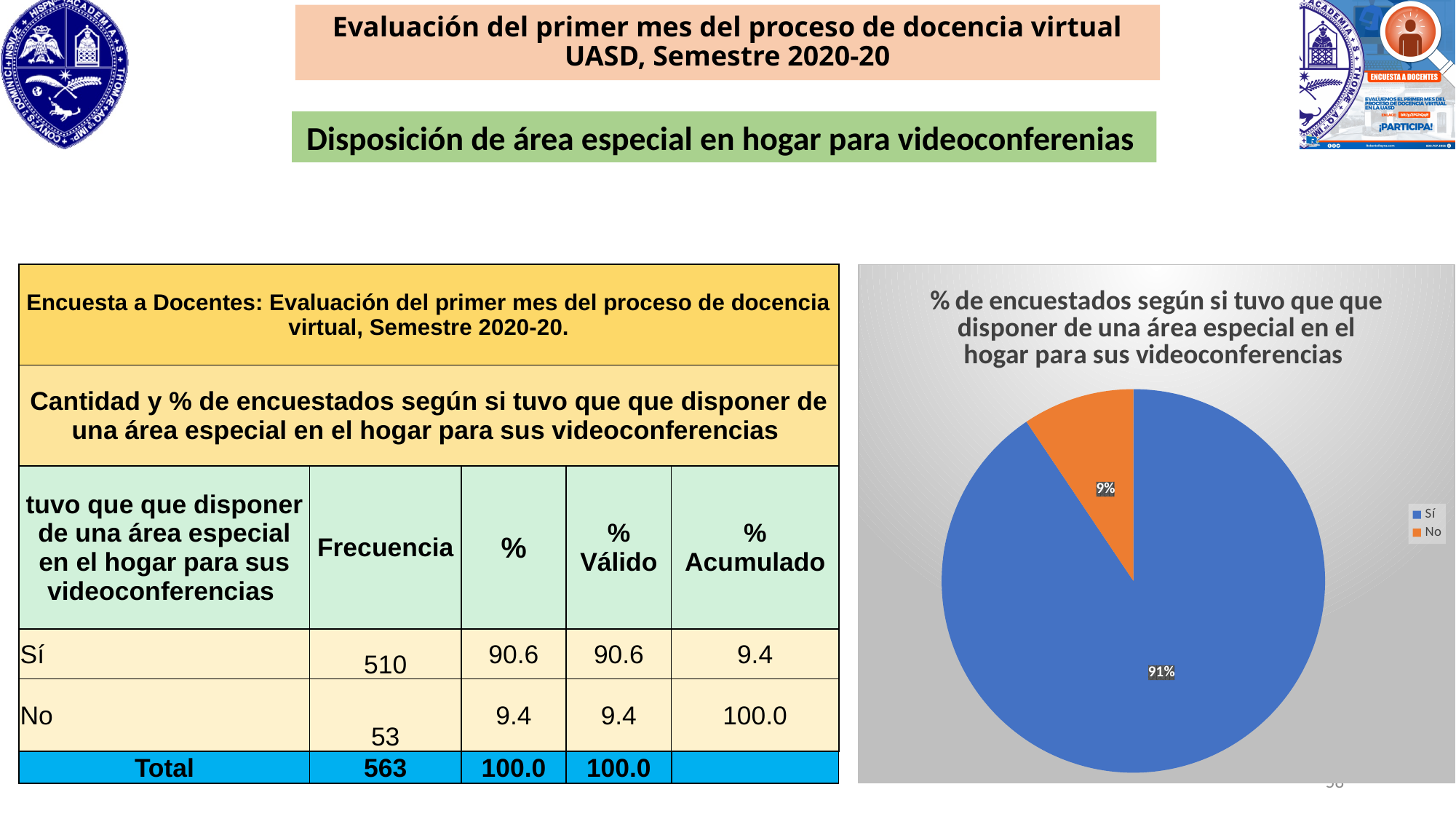
What is the difference in percentage points between the "Sí" and "No" slices in the pie chart? 82 Which category has the largest slice in the pie chart? Sí Which slice is larger in the pie chart, "Sí" or "No"? Sí What kind of chart is shown on the slide? pie chart What percentage does the pie chart show for "No"? 9% What colour is the "No" slice in the pie chart? orange What colour is the "Sí" slice in the pie chart? blue How many entries does the pie chart's legend list? 2 What percentage does the pie chart show for "Sí"? 91% How many slices does the pie chart have? 2 Which category has the smallest slice in the pie chart? No